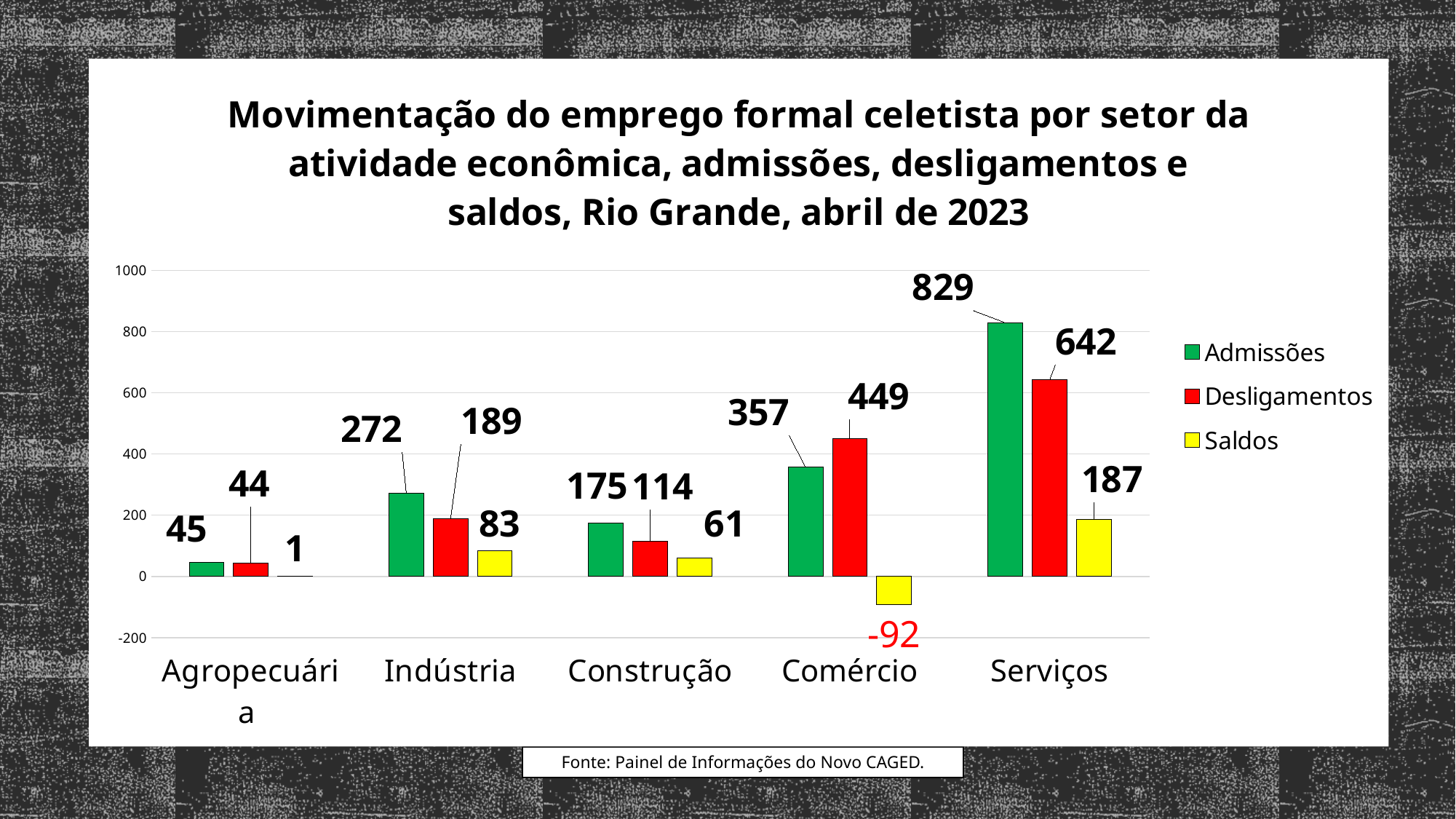
What is the difference between Admissões and Desligamentos for Construção? 61 Which sector has the lowest Saldos value? Comércio What is the value of Admissões for Serviços? 829 Which colour represents the Saldos series in the legend? Yellow What is the value of Desligamentos for Indústria? 189 What is the value of Saldos for Agropecuária? 1 Which sector has the highest Admissões value? Serviços For Comércio, which is larger: Admissões or Desligamentos? Desligamentos How many sectors are shown on the x axis? 5 What kind of chart is shown on the slide? Bar chart How many series does the legend list? 3 What is the value of Saldos for Comércio? -92